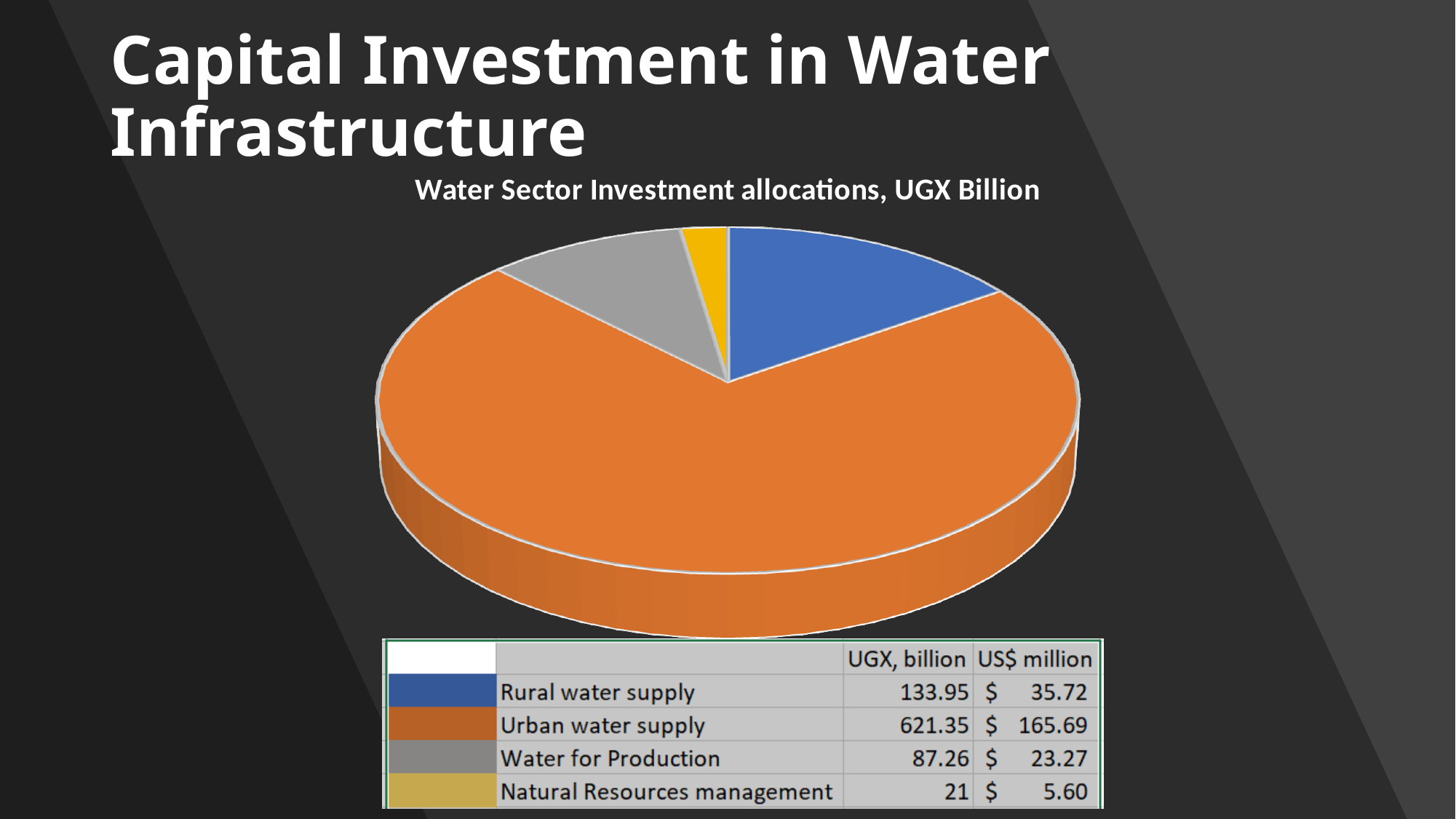
What is the UGX billion value for Urban water supply? 621.35 What is the UGX billion value for Rural water supply? 133.95 What is the difference in UGX billion between Urban water supply and Rural water supply? 487.40 How many categories does the pie chart have? 4 Which category has the smallest allocation? Natural Resources management Which category has the largest allocation? Urban water supply What is the UGX billion value for Water for Production? 87.26 Which is larger, the allocation for Rural water supply or for Water for Production? Rural water supply What is the US$ million value for Natural Resources management? 5.60 What is the title of the chart? Water Sector Investment allocations, UGX Billion Which colour represents Water for Production in the pie chart? Grey What kind of chart is shown on the slide? Pie chart